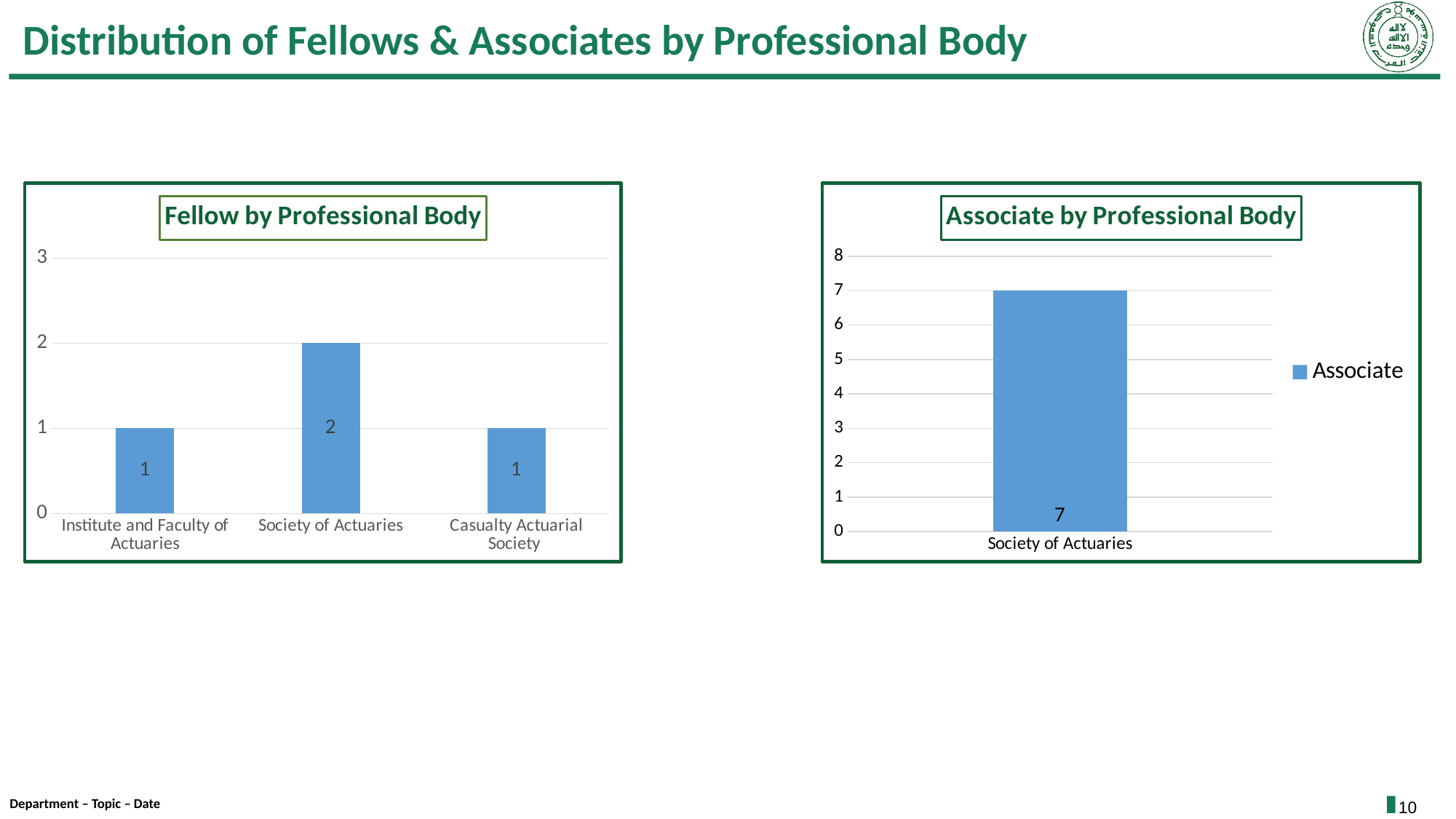
In the 'Associate by Professional Body' chart, what is the value for Society of Actuaries? 7 In the 'Fellow by Professional Body' chart, how many professional bodies are shown? 3 In the 'Fellow by Professional Body' chart, what is the value for Casualty Actuarial Society? 1 In the 'Associate by Professional Body' chart, how many series does the legend list? 1 In the 'Fellow by Professional Body' chart, which is larger: the value for Society of Actuaries or the value for Institute and Faculty of Actuaries? Society of Actuaries In the 'Fellow by Professional Body' chart, what is the value for Society of Actuaries? 2 What kind of chart is the 'Associate by Professional Body' chart? Bar chart In the 'Fellow by Professional Body' chart, what is the value for Institute and Faculty of Actuaries? 1 In the 'Associate by Professional Body' chart, what is the legend entry? Associate In the 'Fellow by Professional Body' chart, what is the difference between the values for Society of Actuaries and Casualty Actuarial Society? 1 In the 'Fellow by Professional Body' chart, which professional body has the highest value? Society of Actuaries In the 'Associate by Professional Body' chart, how many categories are shown? 1